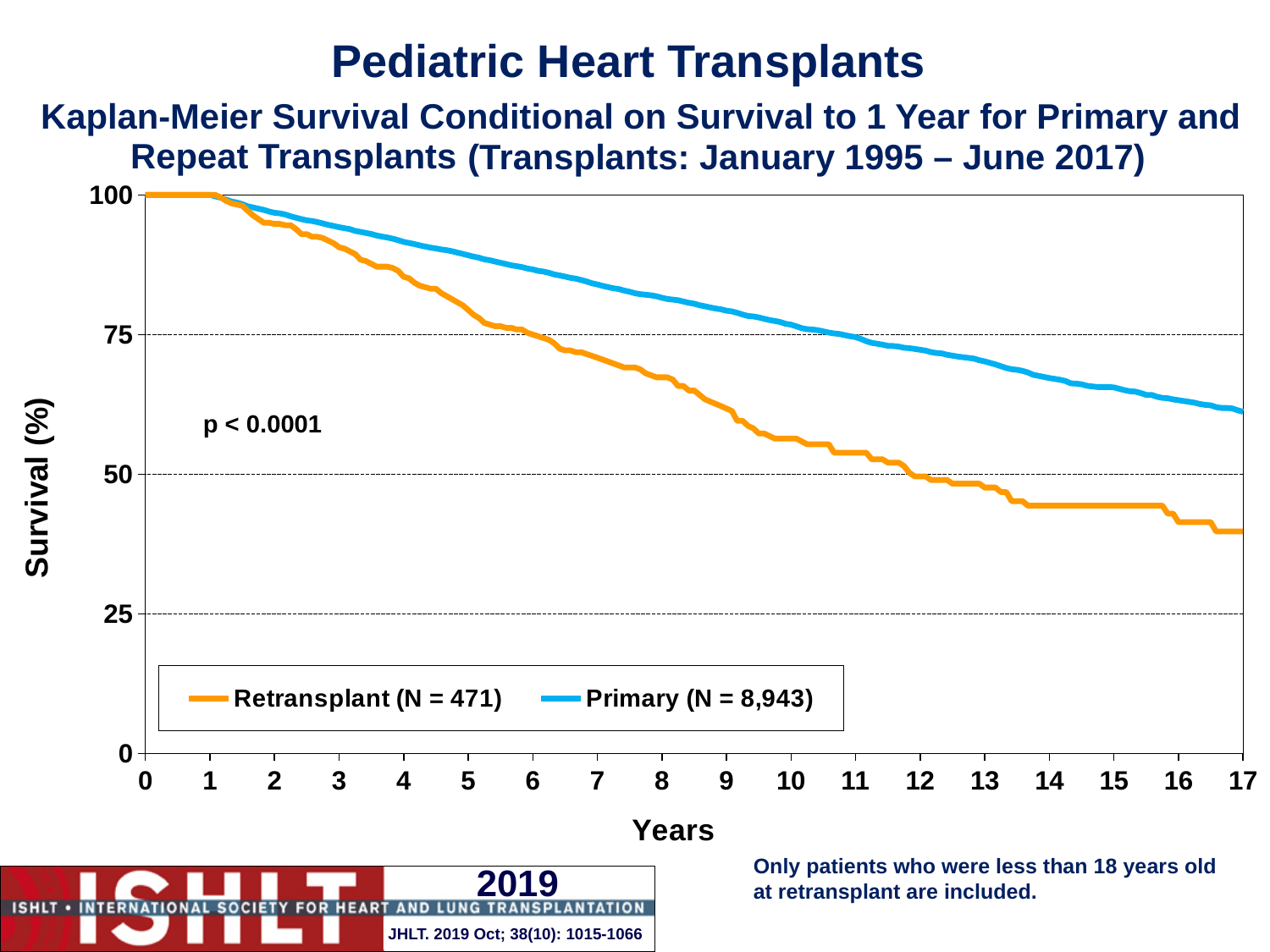
Is the survival value for Primary at 10 years greater or less than 75? greater Is the survival value for Retransplant at 8 years greater or less than 75? less What kind of chart is shown on the slide? line chart Is the survival value for Retransplant at 17 years greater or less than 50? less At 10 years, which group has the higher survival, Retransplant or Primary? Primary What is N for the Primary group in the legend? 8,943 What p-value is shown on the chart? p < 0.0001 How many series does the legend list? 2 Do the survival curves rise or fall as years increase? fall What is the survival value for both groups at 1 year? 100